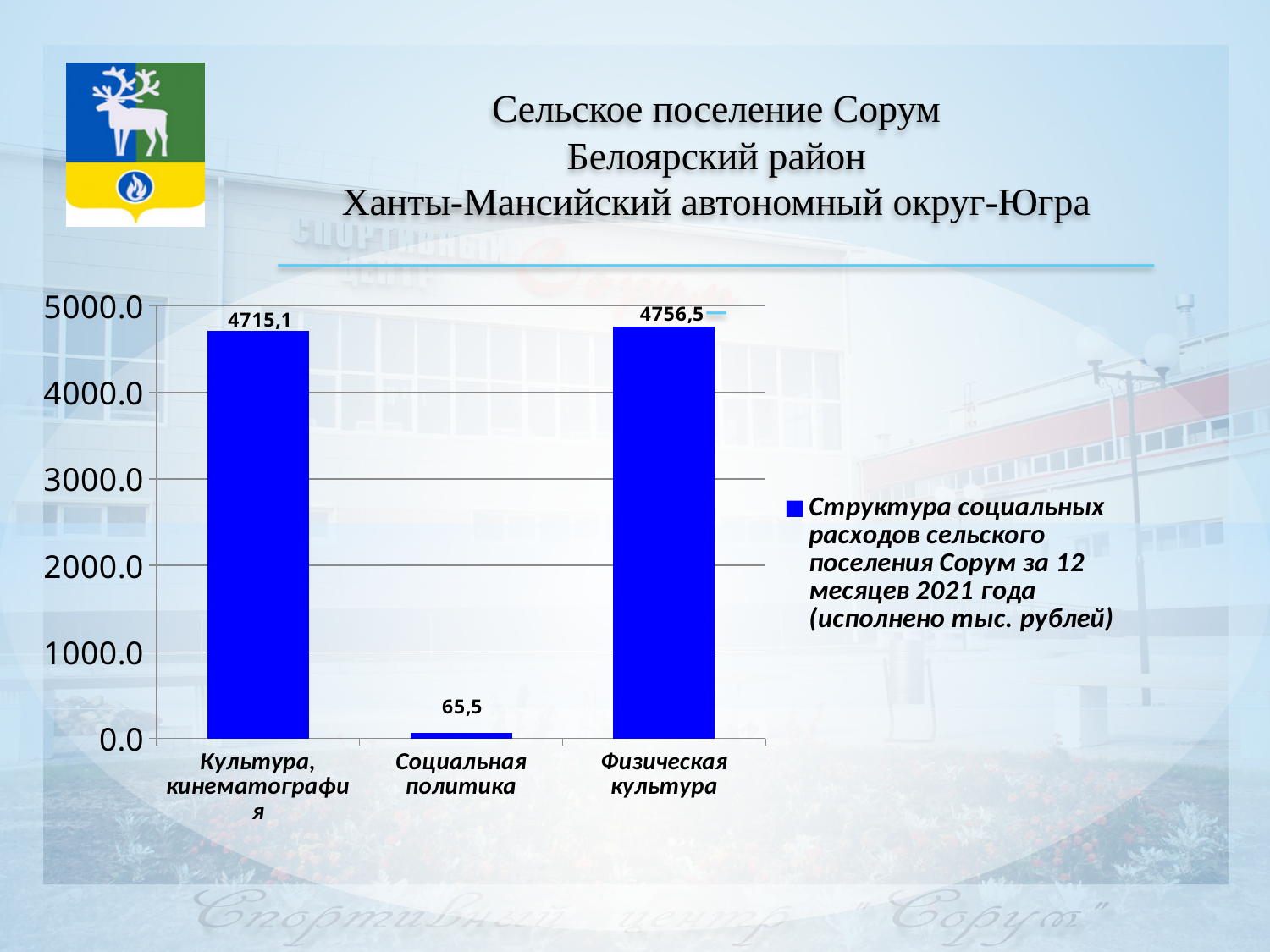
What is the difference between the values for Физическая культура and Культура, кинематография? 41,4 What is the value for Социальная политика? 65,5 What is the difference between the values for Культура, кинематография and Социальная политика? 4649,6 What is the value for Физическая культура? 4756,5 What kind of chart is shown on the slide? bar chart How many categories are shown on the x axis? 3 How many series does the legend list? 1 What is the value for Культура, кинематография? 4715,1 Which category has the lowest value? Социальная политика Is the value for Социальная политика greater or less than 1000.0? less Which is larger, the value for Физическая культура or the value for Социальная политика? Физическая культура Which category has the highest value? Физическая культура